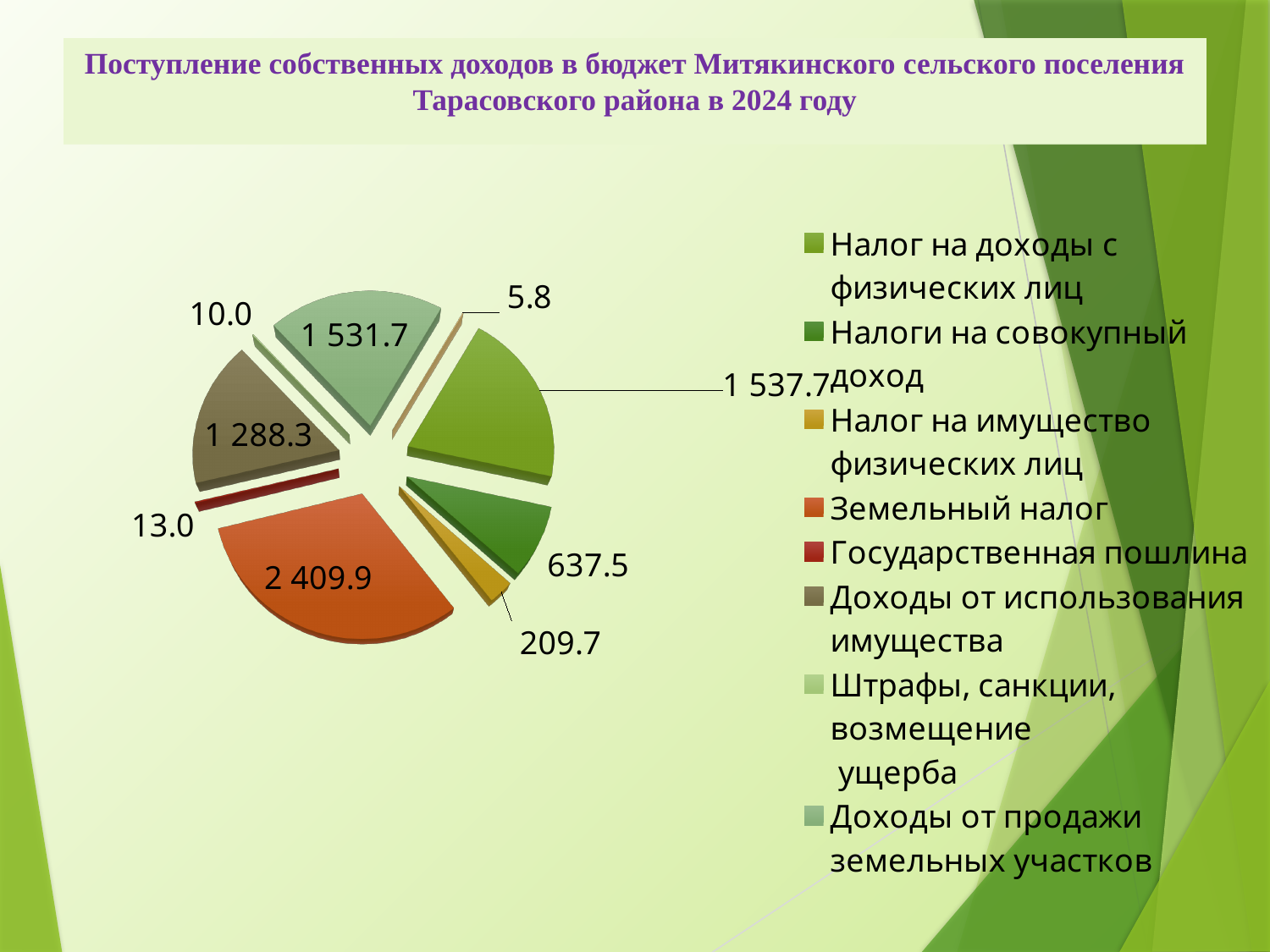
Which is larger: Доходы от использования имущества or Налоги на совокупный доход? Доходы от использования имущества How many entries does the legend list? 8 What is the value for Государственная пошлина? 13.0 What is the value for Земельный налог? 2 409.9 How many slices with data labels does the pie chart have? 9 What is the value for Налог на имущество физических лиц? 209.7 What is the difference between the values for Земельный налог and Налог на доходы с физических лиц? 872.2 Which category has the largest slice of the pie? Земельный налог What is the value for Доходы от использования имущества? 1 288.3 What type of chart is shown on the slide? Pie chart What is the value for Налоги на совокупный доход? 637.5 What is the value for Налог на доходы с физических лиц? 1 537.7